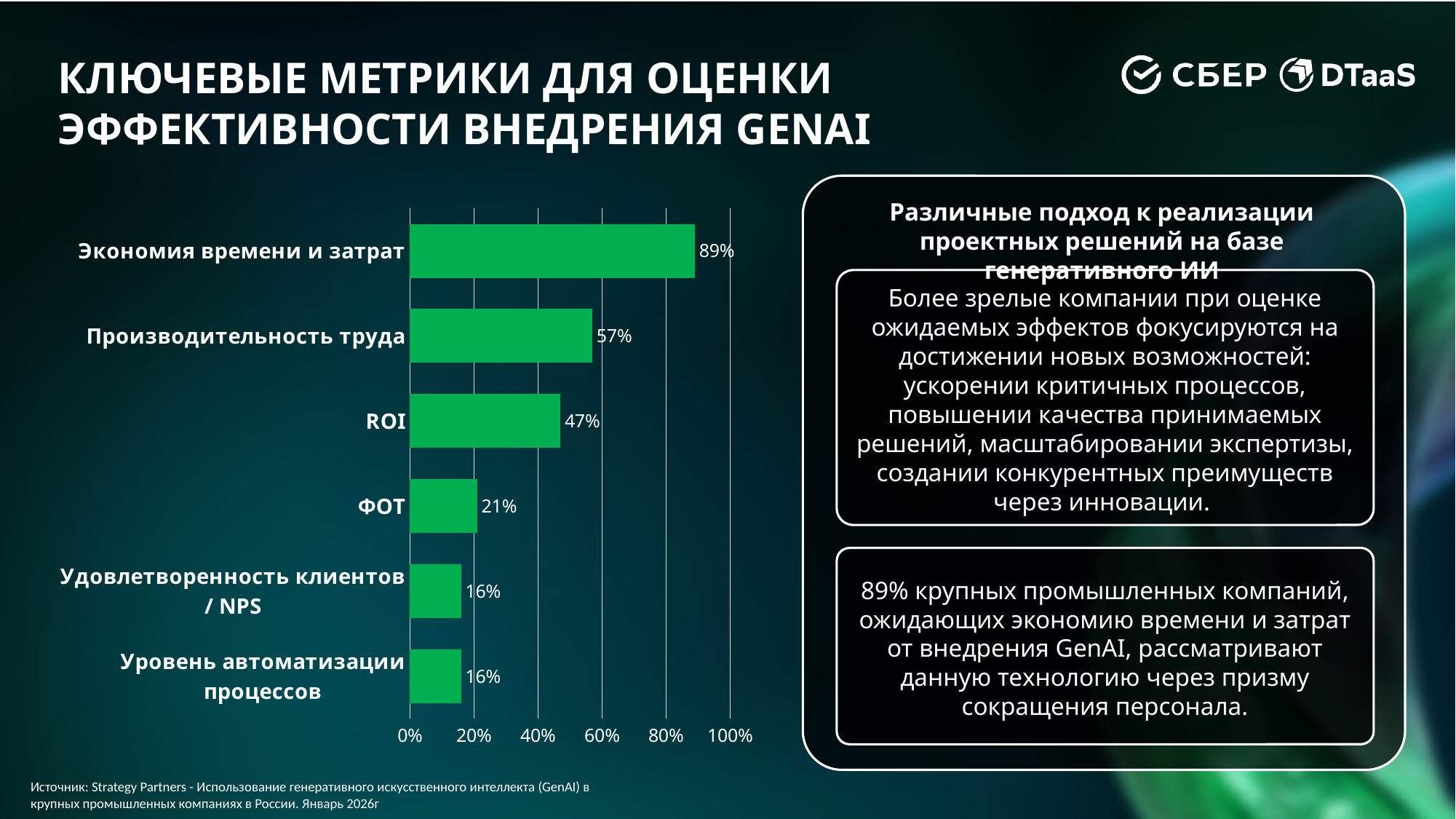
Is the value for Экономия времени и затрат greater or less than 80%? greater What is the value for ROI? 47% What is the value for Уровень автоматизации процессов? 16% How many categories are shown in the chart? 6 What kind of chart is shown on the slide? bar chart What is the value for Экономия времени и затрат? 89% Which category has the highest value? Экономия времени и затрат What is the difference between the values for ROI and ФОТ? 26% What is the value for Производительность труда? 57% What is the difference between the values for Экономия времени и затрат and Производительность труда? 32% What is the value for ФОТ? 21% Which is larger, the value for Производительность труда or the value for ROI? Производительность труда